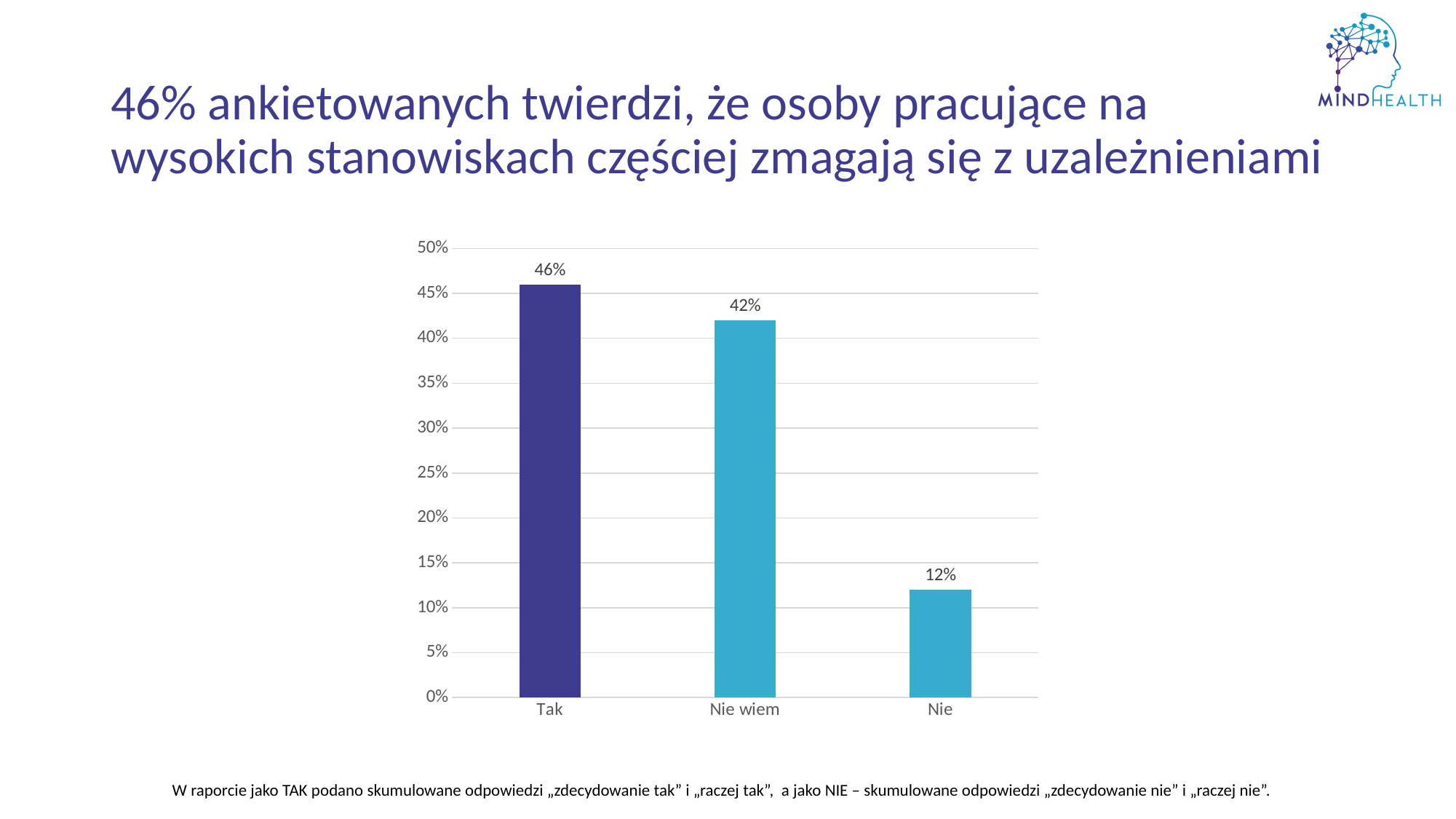
Which category has the lowest value? Nie Which category has the highest value? Tak Which is larger, the value for "Nie wiem" or the value for "Nie"? Nie wiem What kind of chart is shown on the slide? bar chart What is the value for "Nie wiem"? 42% What is the value for "Nie"? 12% What is the value for "Tak"? 46% What is the difference between the values for "Tak" and "Nie wiem"? 4% Which bar is shown in a darker colour than the other two? Tak What is the difference between the values for "Tak" and "Nie"? 34% How many categories are shown on the x axis? 3 Is the value for "Nie wiem" greater or less than 40%? greater